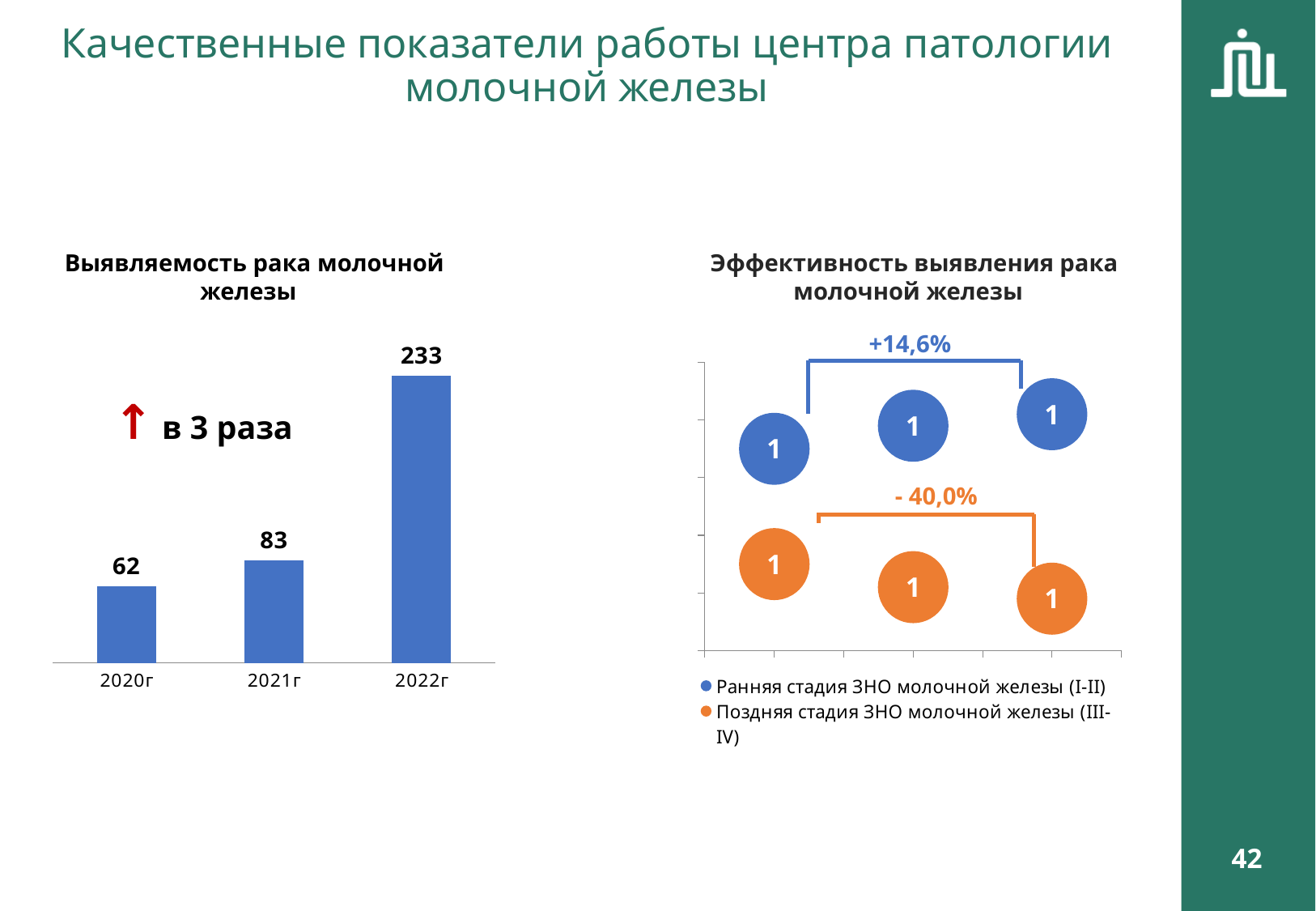
On the chart "Выявляемость рака молочной железы", what is the value for 2022г? 233 On the chart "Выявляемость рака молочной железы", which year has the highest value? 2022г On the chart "Выявляемость рака молочной железы", how many years are shown on the x axis? 3 On the chart "Выявляемость рака молочной железы", what is the difference between the values for 2022г and 2021г? 150 On the chart "Выявляемость рака молочной железы", what is the value for 2020г? 62 On the chart "Выявляемость рака молочной железы", which year has the lowest value? 2020г On the chart "Выявляемость рака молочной железы", do the values rise or fall from 2020г to 2022г? Rise On the chart "Выявляемость рака молочной железы", what is the value for 2021г? 83 On the chart "Выявляемость рака молочной железы", what is the difference between the values for 2021г and 2020г? 21 On the chart "Выявляемость рака молочной железы", which is larger, the value for 2020г or 2021г? 2021г What kind of chart is "Выявляемость рака молочной железы"? Bar chart On the chart "Эффективность выявления рака молочной железы", how many series does the legend list? 2